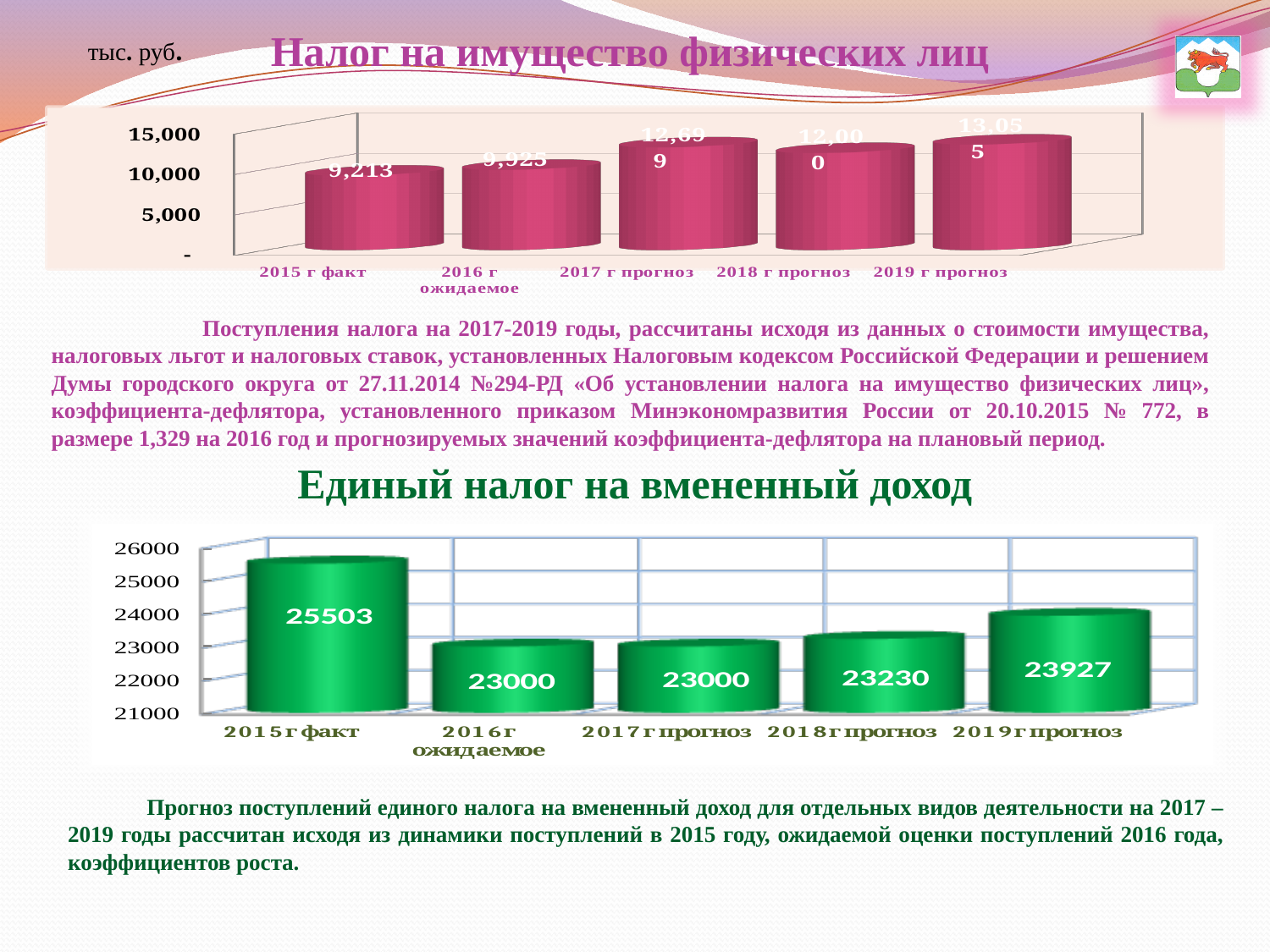
In the top chart (Налог на имущество физических лиц), which category has the lowest value? 2015 г факт In the top chart (Налог на имущество физических лиц), is the value for 2019 г прогноз greater or less than 10,000? greater In the bottom chart (Единый налог на вмененный доход), what is the difference between the values for 2015 г факт and 2019 г прогноз? 1576 In the top chart (Налог на имущество физических лиц), what is the difference between the values for 2016 г ожидаемое and 2015 г факт? 712 How many categories are shown in the bottom chart (Единый налог на вмененный доход)? 5 What kind of chart is the bottom chart (Единый налог на вмененный доход)? bar chart In the top chart (Налог на имущество физических лиц), what is the value for 2016 г ожидаемое? 9,925 In the bottom chart (Единый налог на вмененный доход), which category has the highest value? 2015 г факт In the bottom chart (Единый налог на вмененный доход), which is larger: the value for 2018 г прогноз or 2019 г прогноз? 2019 г прогноз In the bottom chart (Единый налог на вмененный доход), what is the value for 2019 г прогноз? 23927 In the top chart (Налог на имущество физических лиц), what is the value for 2015 г факт? 9,213 In the bottom chart (Единый налог на вмененный доход), what is the value for 2015 г факт? 25503